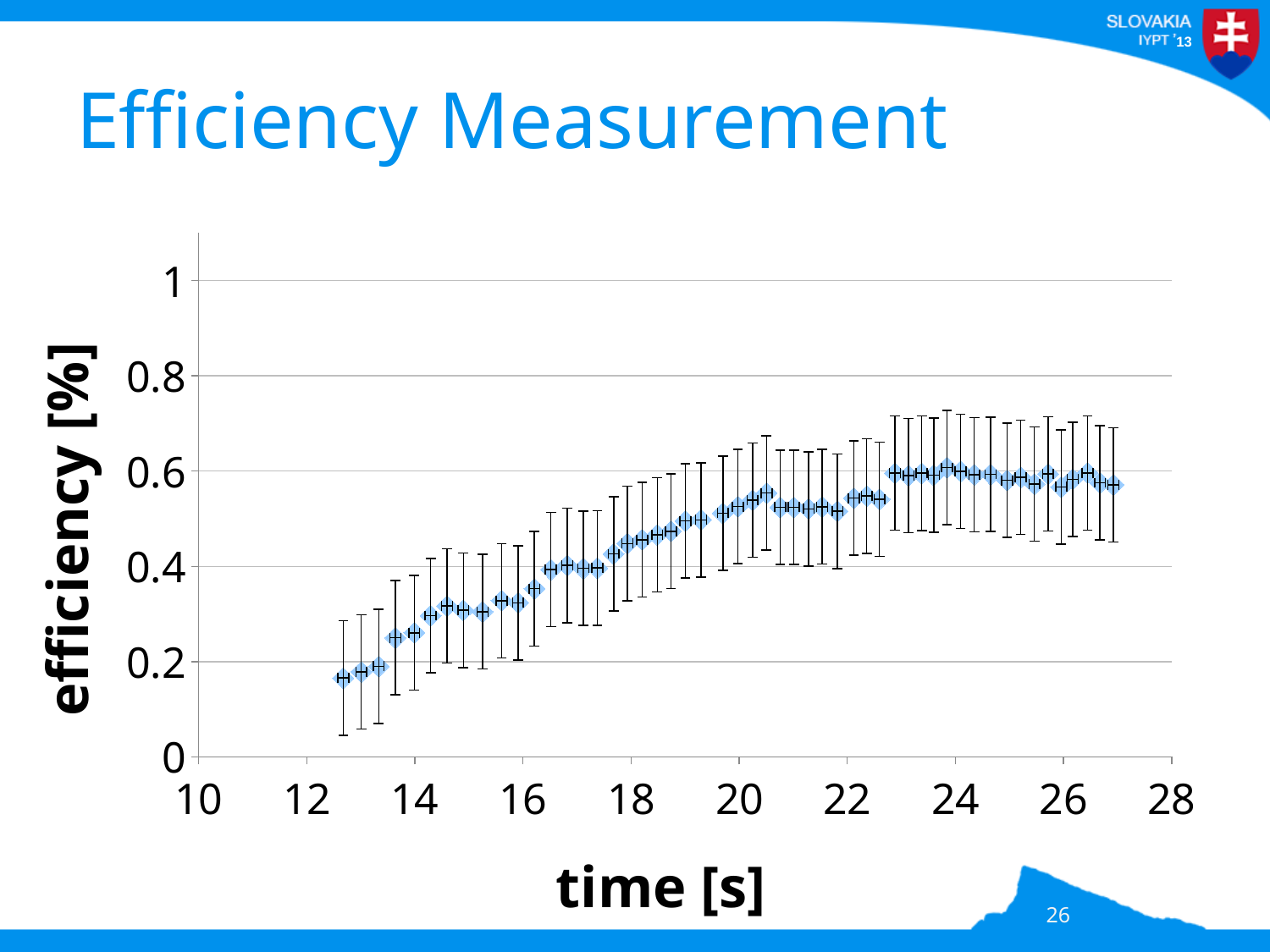
Is the lowest efficiency found at the start or at the end of the measured time range? start What kind of chart is shown on the slide? scatter chart Which has the higher efficiency, the point at 16 s or the point at 22 s? 22 s Does efficiency generally rise or fall as time increases from 12 s to 24 s? rise What is the label of the y axis? efficiency [%] Is the efficiency at 14 s greater or less than 0.2? greater Is the efficiency at 24 s greater or less than 0.4? greater Which has the higher efficiency, the point at 14 s or the point at 24 s? 24 s Is the efficiency at 20 s greater or less than 0.6? less What is the title of the slide containing the chart? Efficiency Measurement